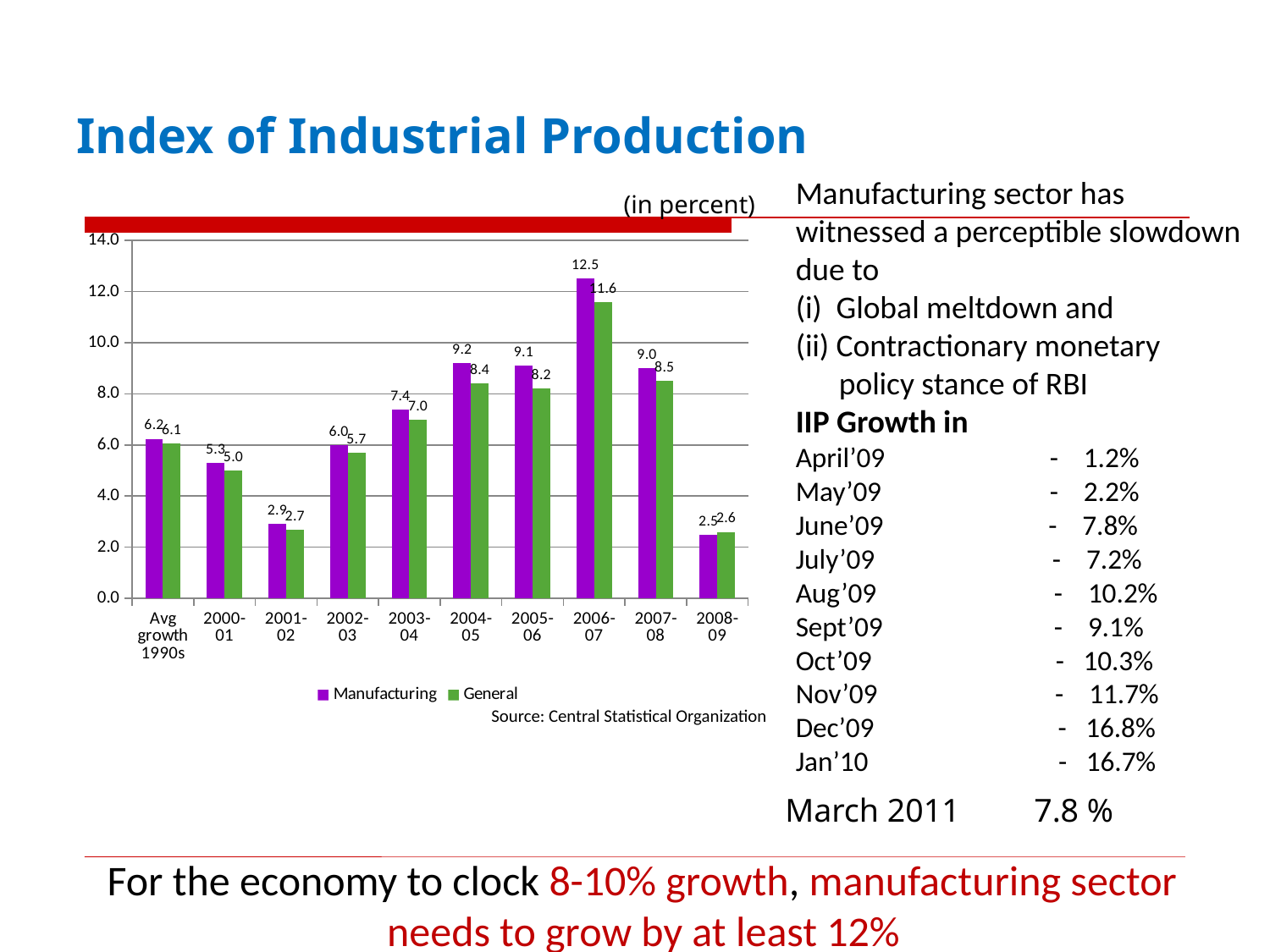
What is the source cited below the chart? Central Statistical Organization How many series does the legend list? 2 What is the Manufacturing value for 2008-09? 2.5 Is the Manufacturing value for 2001-02 greater or less than 4.0? less Which category has the highest Manufacturing value? 2006-07 How many categories are shown on the x axis? 10 Which category has the lowest General value? 2008-09 What is the difference between the Manufacturing and General values for 2006-07? 0.9 What is the Manufacturing value for 2006-07? 12.5 What is the General value for 2003-04? 7.0 What kind of chart is shown on the slide? bar chart Which is larger for 2004-05, the Manufacturing value or the General value? Manufacturing